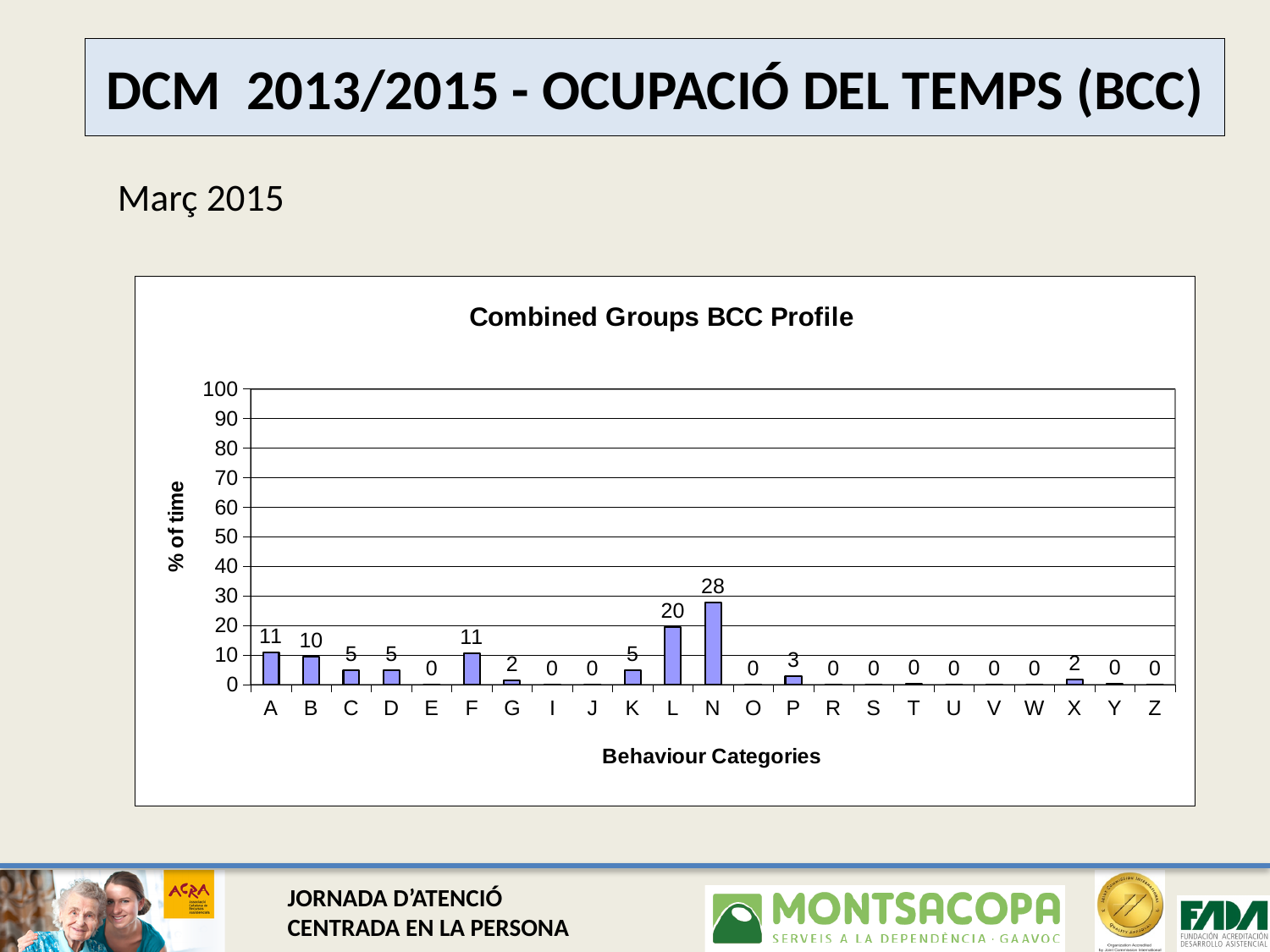
What kind of chart is shown on the slide? bar chart Which behaviour category has the highest % of time? N What is the value for category P? 3 Is the value for N greater or less than 20? greater How many categories have a value of 0? 12 Which is larger, the value for A or the value for B? A What is the difference between the values for N and L? 8 What is the difference between the values for A and C? 6 What is the title of the y axis? % of time What is the value for category L? 20 What is the value for category N in the Combined Groups BCC Profile chart? 28 How many behaviour categories are shown on the x axis? 23